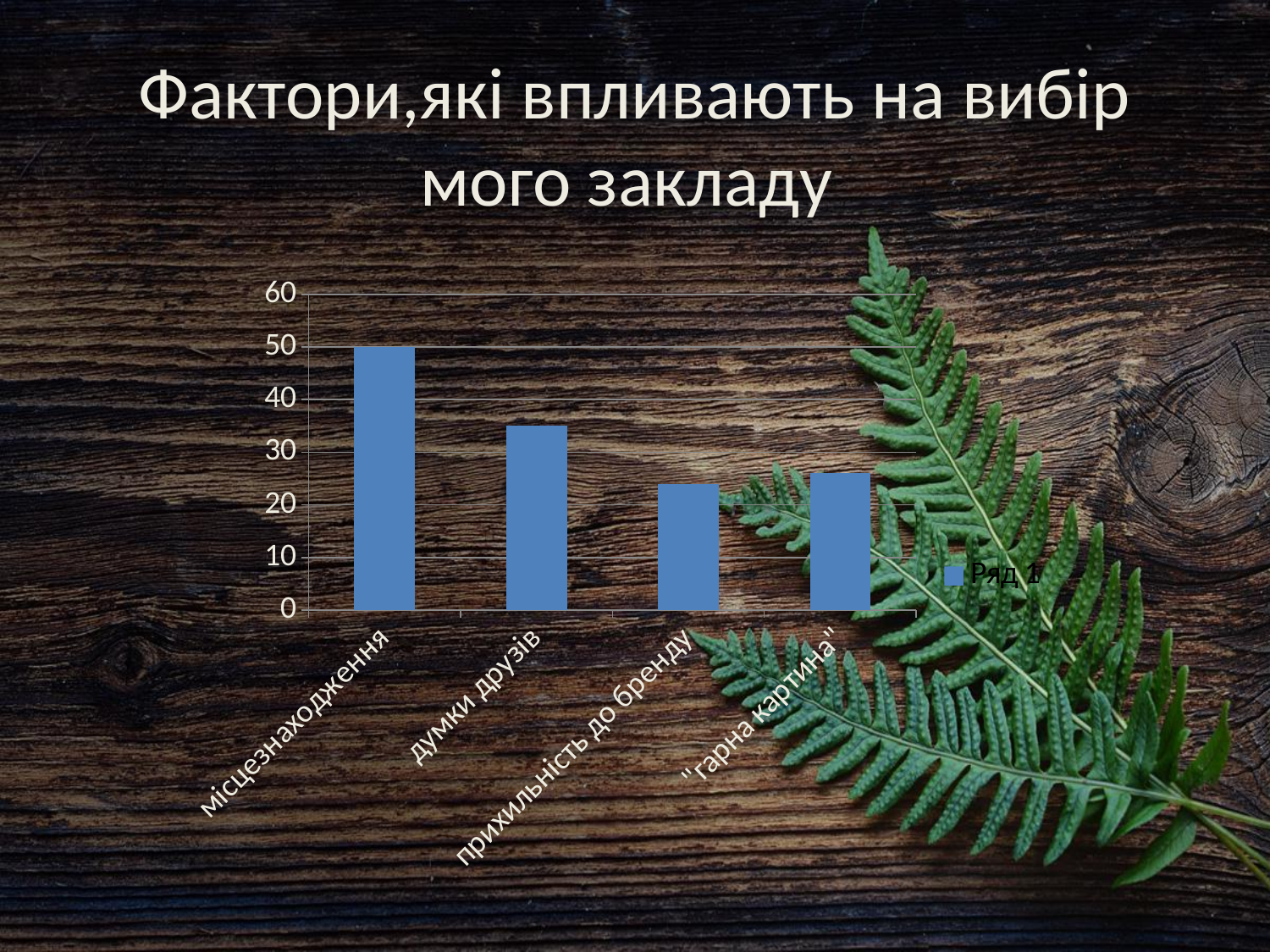
Is the value for "гарна картина" greater or less than 20? greater How many categories are shown on the x axis of the chart? 4 What is the value for місцезнаходження? 50 Is the value for думки друзів greater or less than 30? greater Is the value for думки друзів greater or less than 40? less What is the title of the slide containing the chart? Фактори,які впливають на вибір мого закладу Which category has the highest value in the chart? місцезнаходження Which is larger, the value for місцезнаходження or the value for думки друзів? місцезнаходження What type of chart is shown on the slide? bar chart How many series does the chart legend list? 1 What is the name of the series shown in the legend? Ряд 1